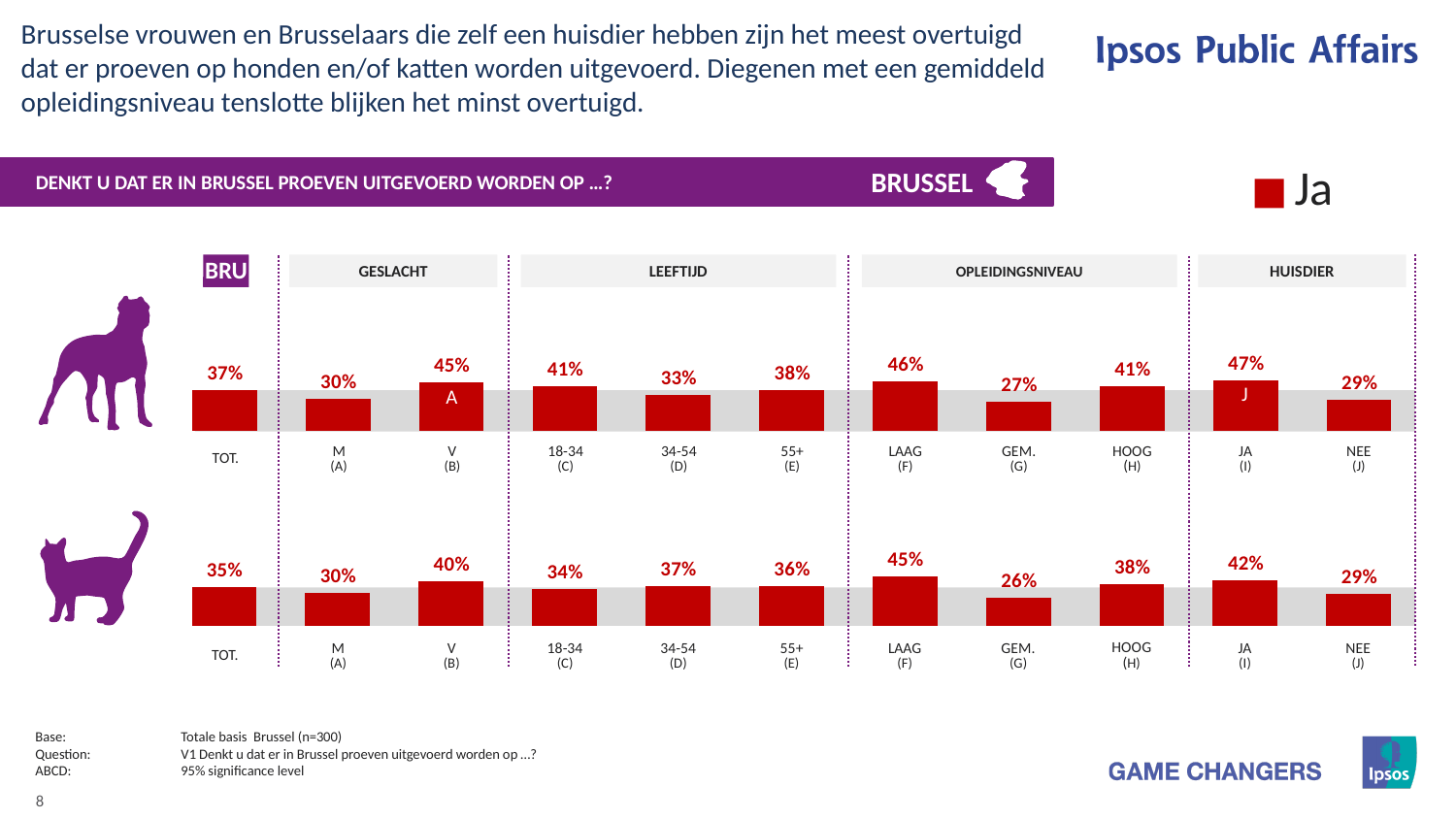
In the top row of bars (dog), which category has the highest value? JA (I) In the top row of bars (dog), what is the difference between the values for V (B) and M (A)? 15% In the top row of bars (dog), which is larger: the value for 18-34 (C) or the value for 55+ (E)? 18-34 (C) In the bottom row of bars (cat), which category has the lowest value? GEM. (G) How many categories are plotted in the top row of bars (dog)? 11 In the top row of bars (dog), what is the value for TOT.? 37% What is the legend entry shown on the slide? Ja How many series does the legend list? 1 In the bottom row of bars (cat), which is larger: the value for JA (I) or the value for NEE (J)? JA (I) In the bottom row of bars (cat), what is the value for HOOG (H)? 38% In the bottom row of bars (cat), what is the difference between the values for LAAG (F) and GEM. (G)? 19% What kind of chart is used on this slide? Bar chart